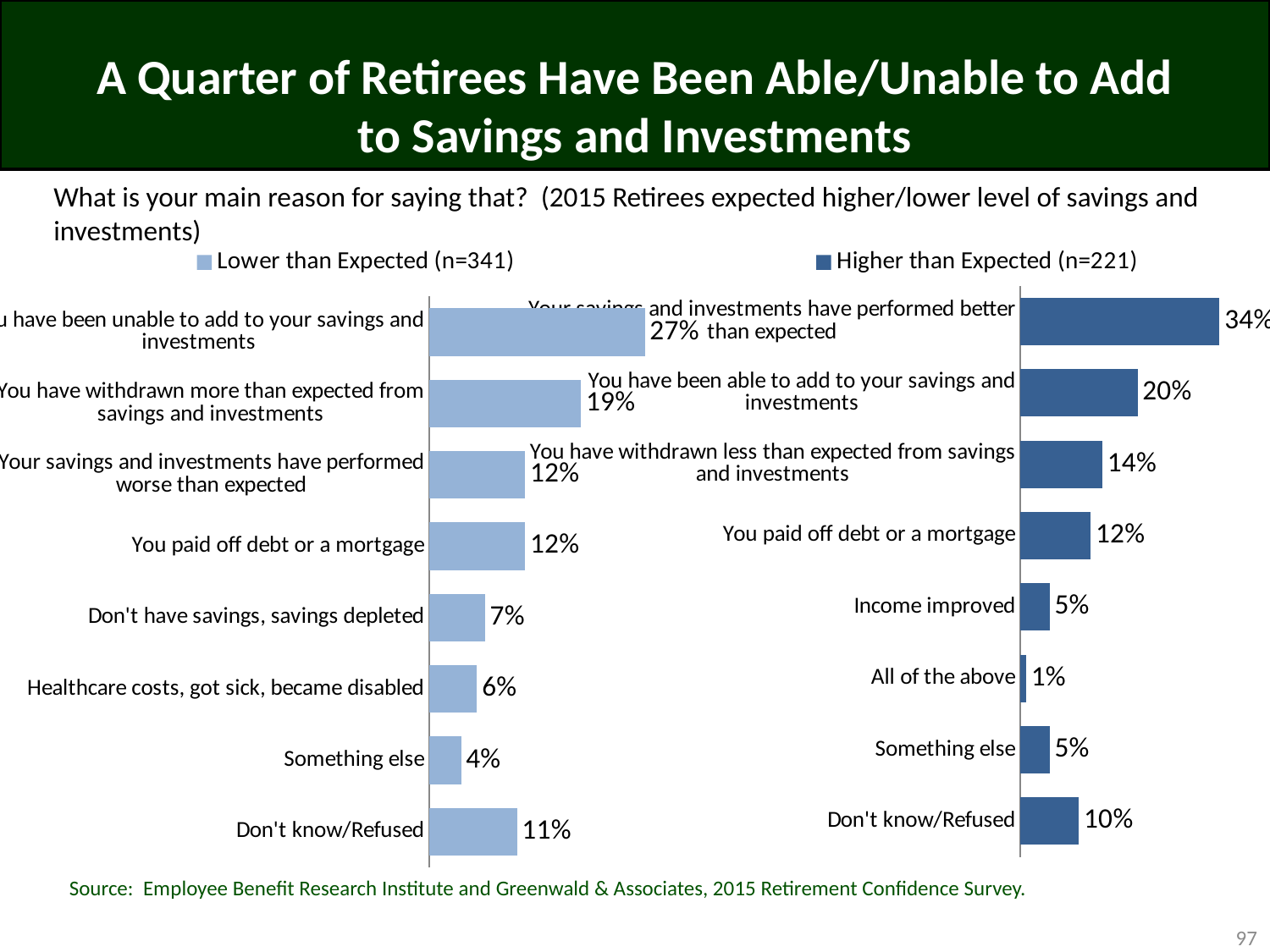
In the Lower than Expected chart, what percentage is shown for "You paid off debt or a mortgage"? 12% In the Lower than Expected chart, what is the difference between "Don't know/Refused" and "Something else"? 7% In the Lower than Expected chart, which category has the lowest value? Something else What is the sample size (n) shown in the legend for the Higher than Expected chart? 221 In the Lower than Expected chart, which category has the highest value? You have been unable to add to your savings and investments In the Higher than Expected chart, which category has the lowest value? All of the above In the Higher than Expected chart, what percentage is shown for "Income improved"? 5% How many categories are shown in the Higher than Expected chart? 8 In the Higher than Expected chart, what percentage is shown for "You have been able to add to your savings and investments"? 20% In the Higher than Expected chart, what is the difference between "Your savings and investments have performed better than expected" and "You have withdrawn less than expected from savings and investments"? 20% Which is larger: "Don't know/Refused" in the Lower than Expected chart or "Don't know/Refused" in the Higher than Expected chart? Lower than Expected What type of chart is the Lower than Expected chart? Bar chart